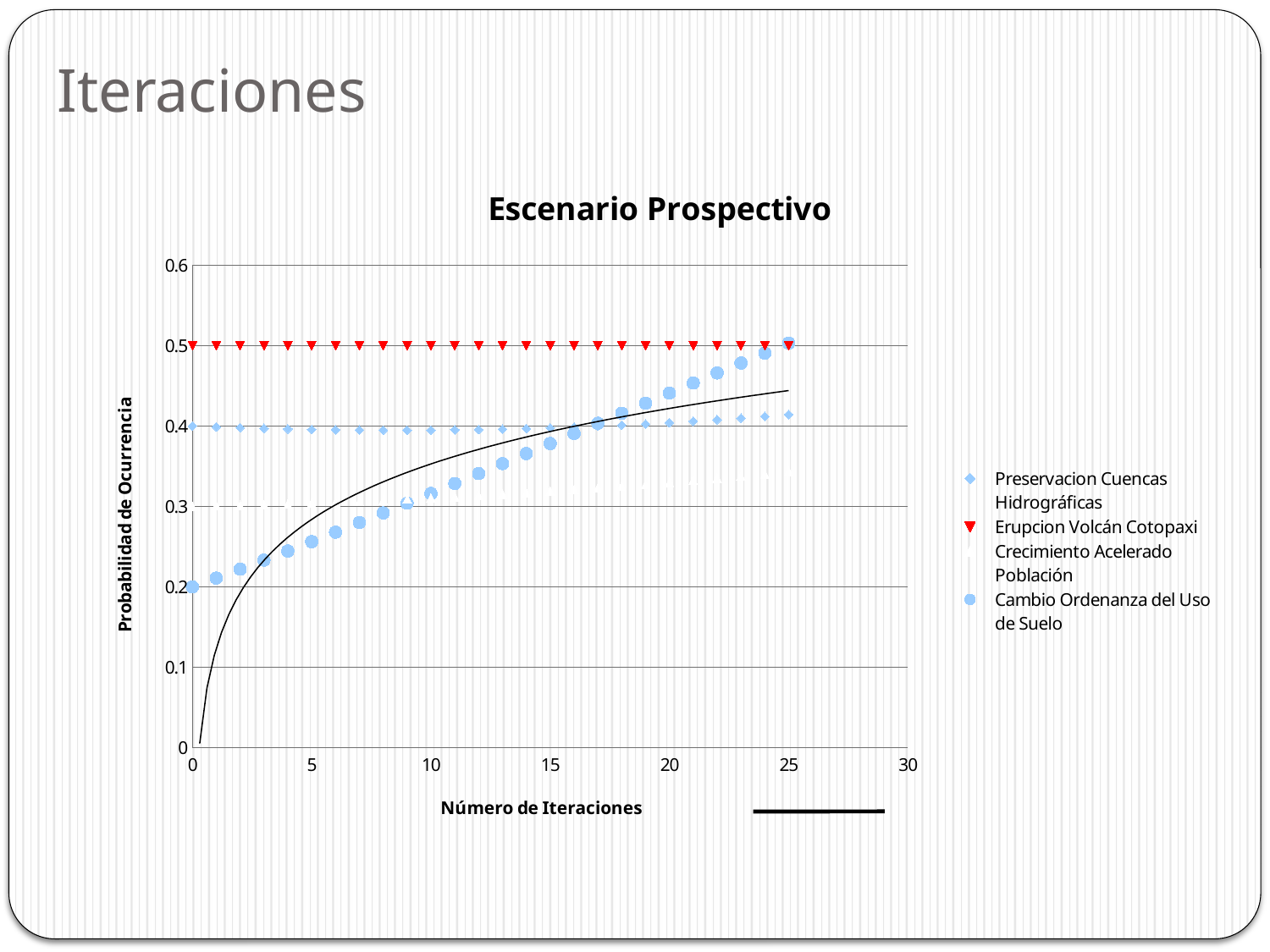
What type of chart is shown on the slide? scatter chart Is the value for Cambio Ordenanza del Uso de Suelo at iteration 20 greater or less than 0.4? greater How many series does the chart legend list? 4 Which series has the highest value at iteration 0? Erupcion Volcán Cotopaxi What is the title of the chart? Escenario Prospectivo Which series has the lowest value at iteration 0? Cambio Ordenanza del Uso de Suelo At iteration 5, which is larger: Erupcion Volcán Cotopaxi or Cambio Ordenanza del Uso de Suelo? Erupcion Volcán Cotopaxi What is the value for Cambio Ordenanza del Uso de Suelo at iteration 0? 0.2 Do the values for Cambio Ordenanza del Uso de Suelo rise or fall as the number of iterations increases? rise What is the probability value for Erupcion Volcán Cotopaxi across the iterations? 0.5 Is the value for Cambio Ordenanza del Uso de Suelo at iteration 10 greater or less than 0.4? less What is the label of the x axis? Número de Iteraciones